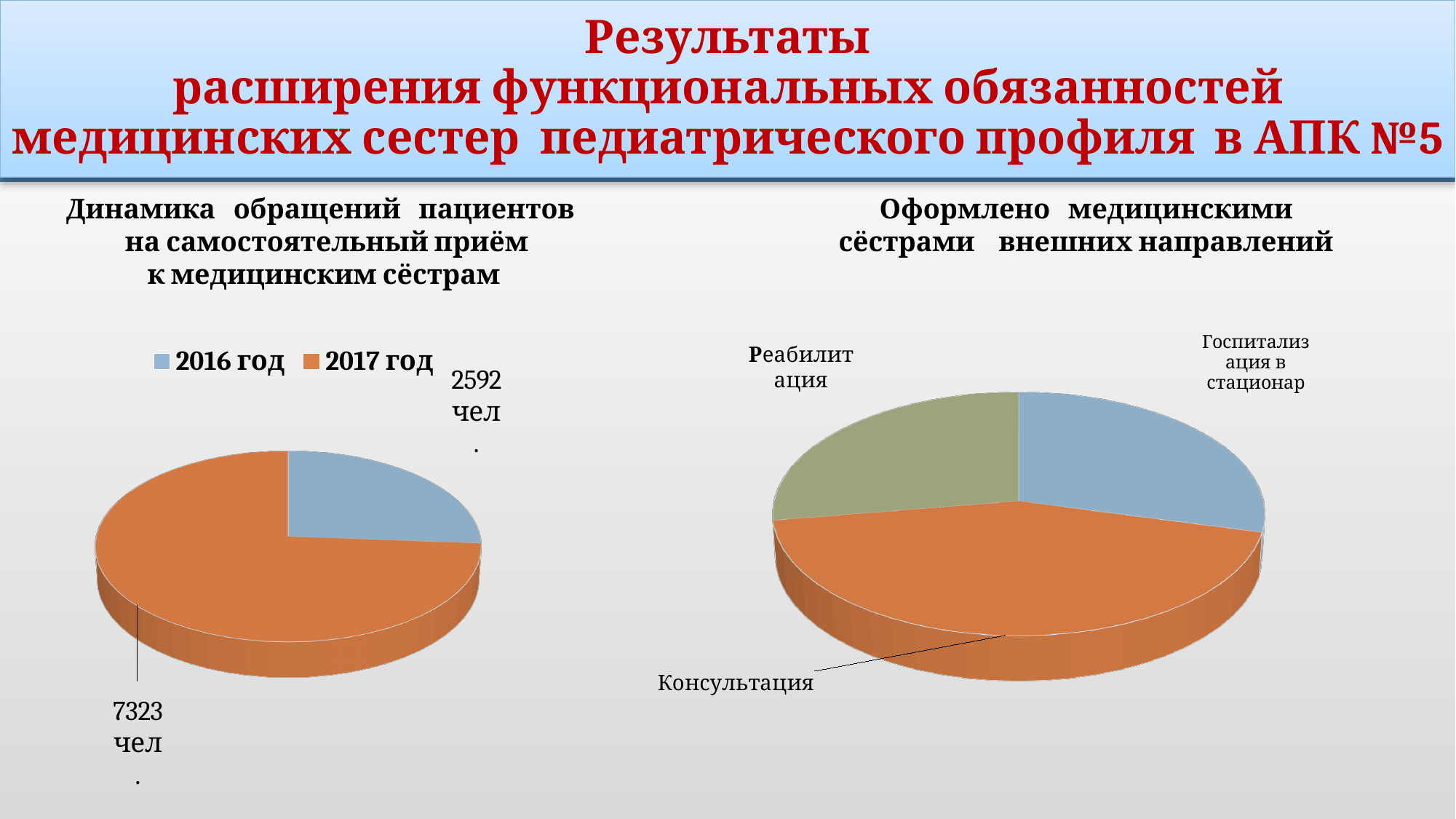
What kind of chart is the left chart? Pie chart What kind of chart is the right chart? Pie chart On the left chart, which year has the larger value, 2016 год or 2017 год? 2017 год On the right chart (Оформлено медицинскими сёстрами внешних направлений), how many categories are shown? 3 On the left chart, which colour represents 2016 год? Blue On the left chart, what is the difference between the 2017 год and 2016 год values? 4731 чел. On the left chart (Динамика обращений пациентов на самостоятельный приём к медицинским сёстрам), what is the value for 2016 год? 2592 чел. On the left chart, how many series does the legend list? 2 On the right chart (Оформлено медицинскими сёстрами внешних направлений), which category has the largest slice? Консультация On the left chart (Динамика обращений пациентов на самостоятельный приём к медицинским сёстрам), what is the value for 2017 год? 7323 чел. On the left chart, which year has the largest slice? 2017 год On the right chart, which colour represents Реабилитация? Green